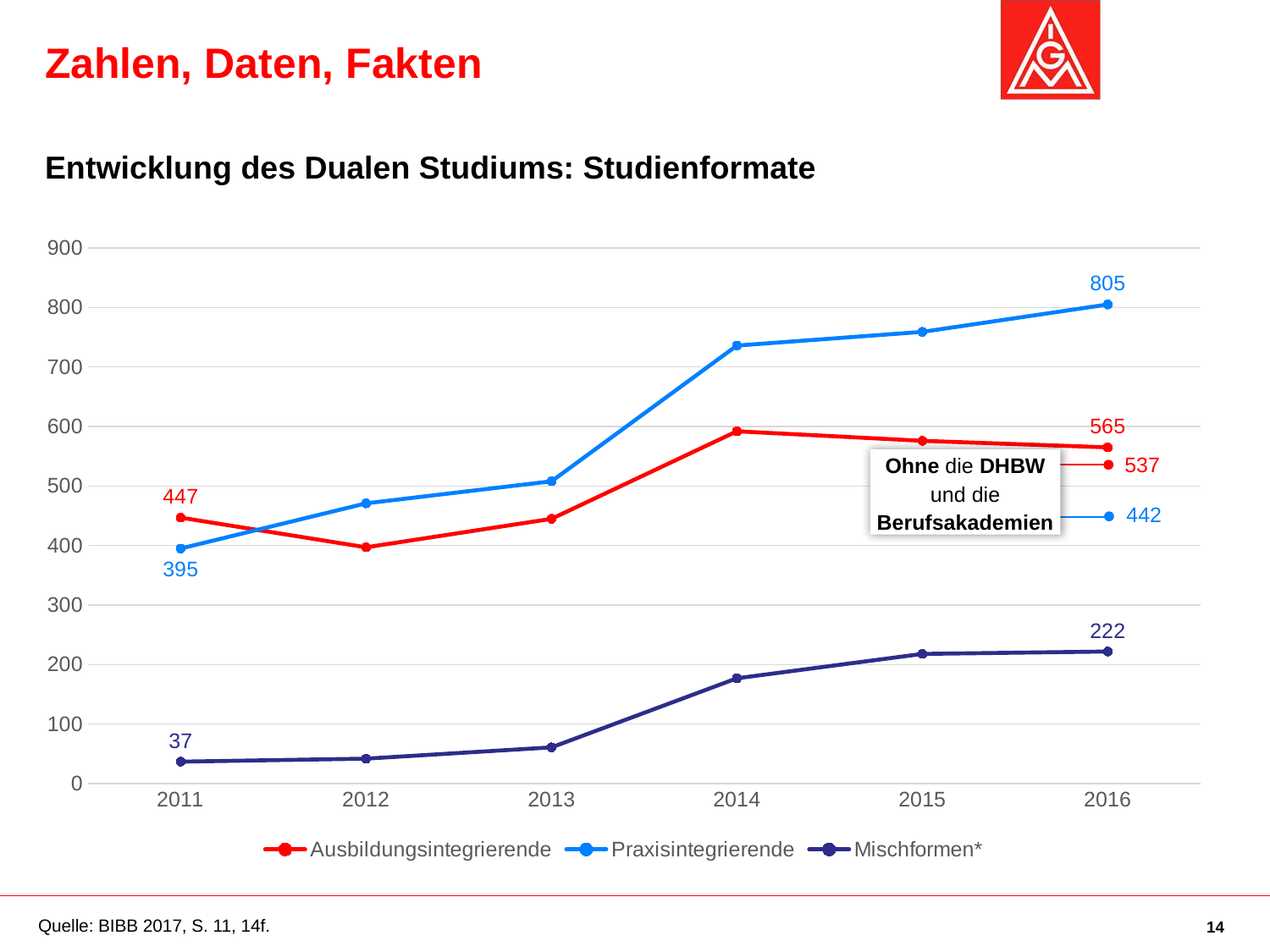
What is the value for Praxisintegrierende in 2011? 395 What is the value for Ausbildungsintegrierende in 2011? 447 What kind of chart is shown on the slide? line chart Which series has the highest value in 2016? Praxisintegrierende What is the difference between the Ausbildungsintegrierende values in 2016 and 2011? 118 How many series does the legend list? 3 In 2011, which was larger: Ausbildungsintegrierende or Praxisintegrierende? Ausbildungsintegrierende What is the value for Mischformen* in 2016? 222 Is the value for Praxisintegrierende in 2014 greater or less than 700? greater How many years are shown on the x axis? 6 What is the value for Praxisintegrierende in 2016? 805 By how much did the Praxisintegrierende value increase from 2011 to 2016? 410